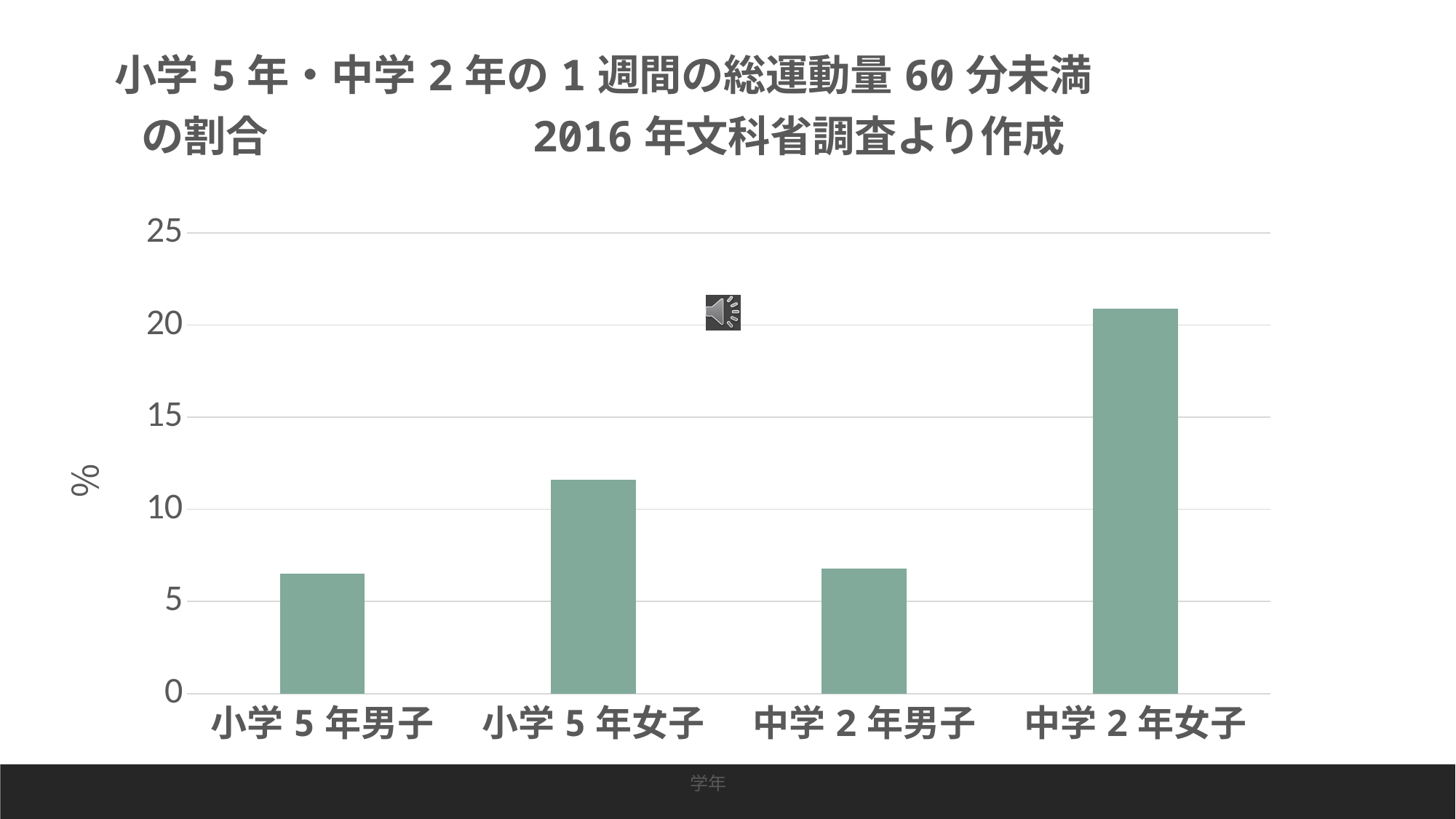
Is the value for 小学5年男子 greater or less than 10? less Which category has the highest value in the chart? 中学2年女子 Is the value for 中学2年男子 greater or less than 5? greater What is the label on the horizontal axis of the chart? 学年 Is the value for 中学2年女子 greater or less than 20? greater Which is larger, the value for 小学5年女子 or the value for 中学2年男子? 小学5年女子 Which is larger, the value for 中学2年女子 or the value for 小学5年男子? 中学2年女子 What kind of chart is shown on the slide? bar chart What is the label on the vertical axis of the chart? % How many categories are shown on the x axis of the chart? 4